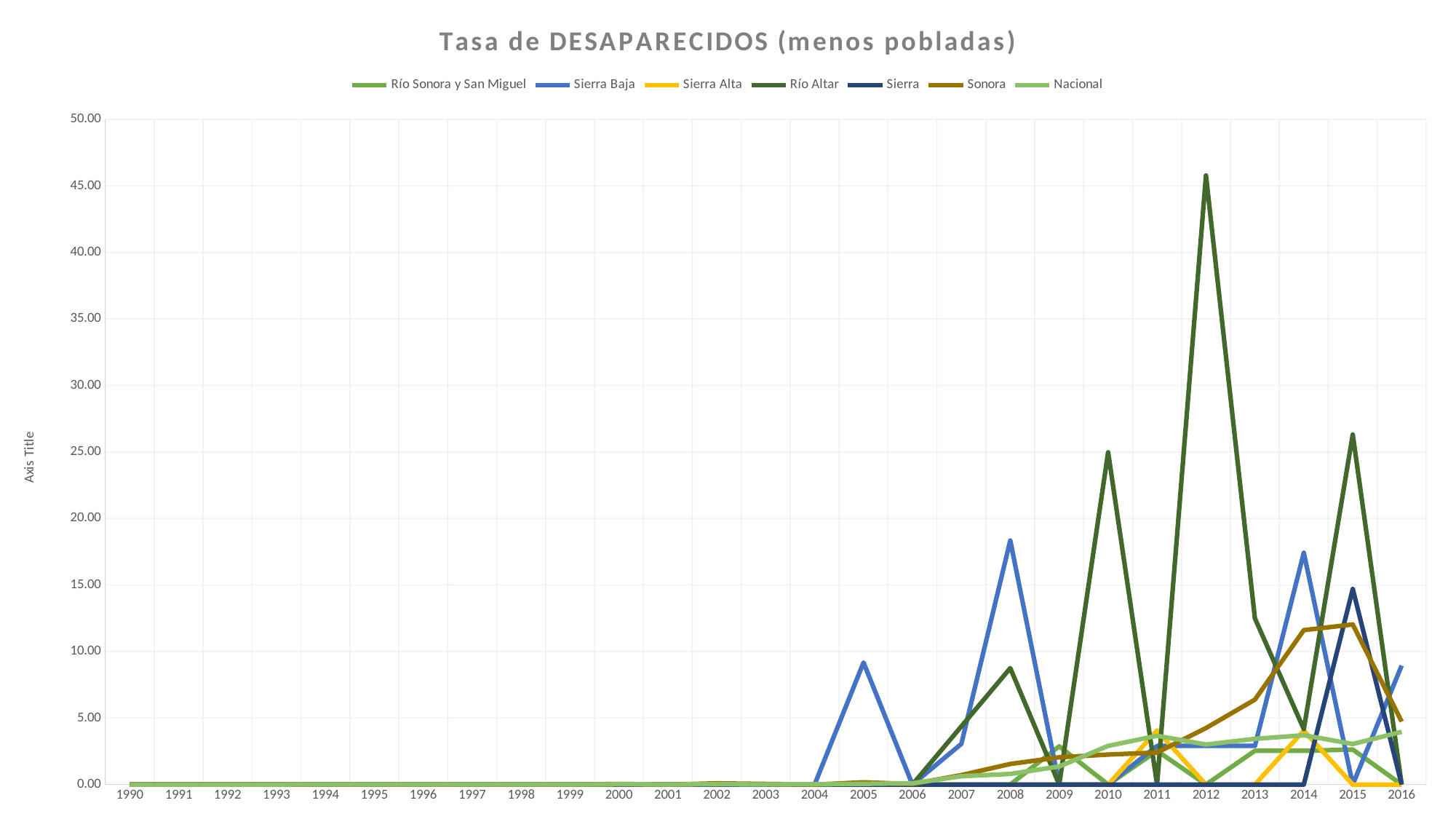
How many series does the legend list? 7 Which series reaches the highest value on the chart? Río Altar Is the value for Río Altar in 2010 greater or less than 20? greater How many years are shown along the x axis? 27 Is the value for Sierra Baja in 2008 greater or less than 15? greater What kind of chart is shown on the slide? line chart What is the title of the chart? Tasa de DESAPARECIDOS (menos pobladas) Is the value for Río Altar in 2012 greater or less than 40? greater What is the label shown on the vertical axis? Axis Title In which year does the Río Altar series reach its highest value? 2012 Which is larger: the Sierra Baja value in 2014 or the Sonora value in 2014? Sierra Baja